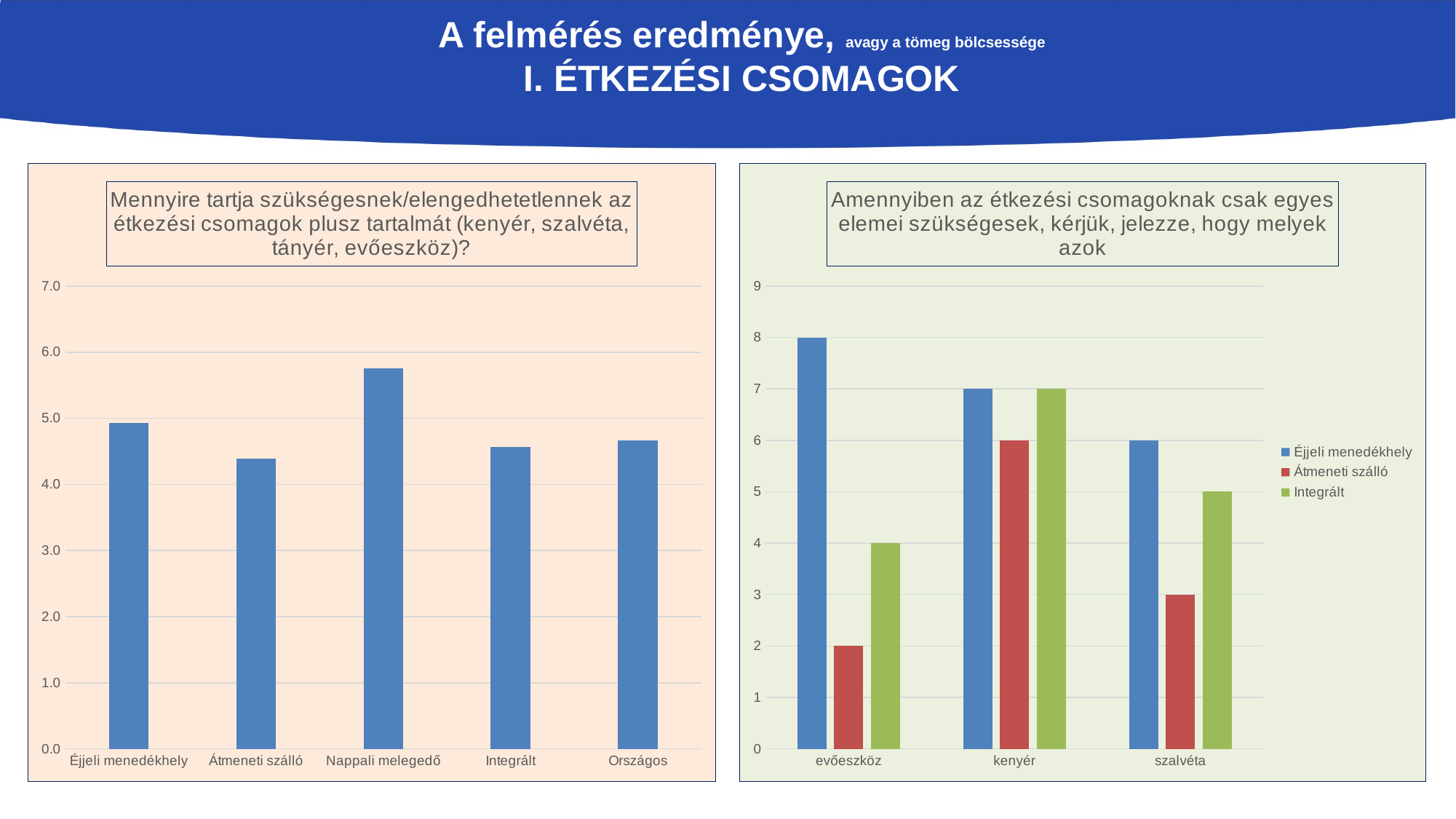
In the right chart, what is the value for Éjjeli menedékhely for evőeszköz? 8 In the right chart, which is larger for szalvéta: Éjjeli menedékhely or Integrált? Éjjeli menedékhely What kind of chart is the left chart? bar chart In the right chart, what is the difference between the Éjjeli menedékhely and Átmeneti szálló values for evőeszköz? 6 In the left chart, which category has the lowest value? Átmeneti szálló In the left chart, which category has the highest value? Nappali melegedő In the right chart, what is the value for Átmeneti szálló for kenyér? 6 How many categories are shown in the left chart? 5 In the left chart, is the value for Nappali melegedő greater or less than 5.0? greater In the left chart, is the value for Átmeneti szálló greater or less than 5.0? less In the right chart, what is the value for Integrált for szalvéta? 5 How many series does the legend of the right chart list? 3